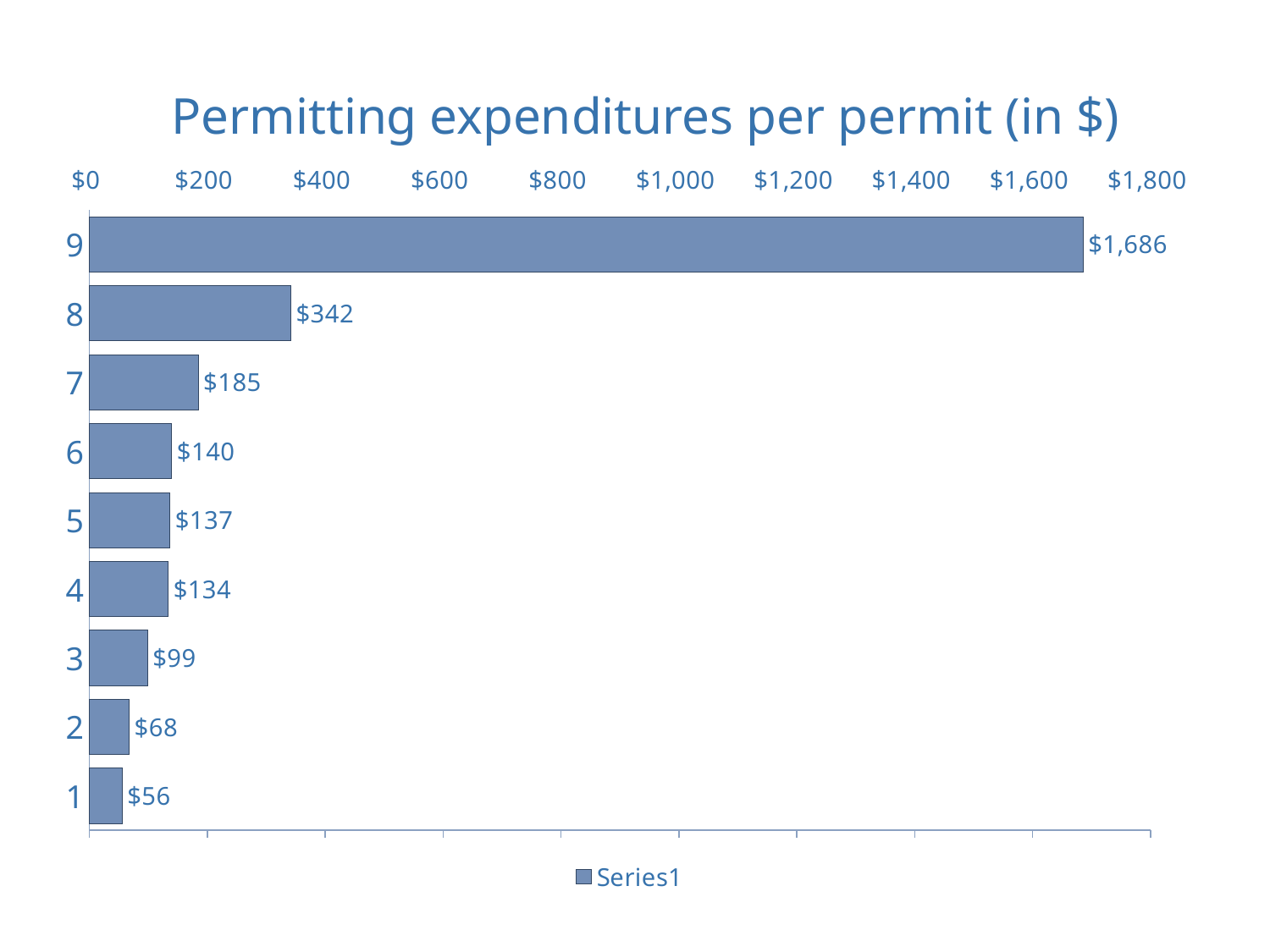
Is the value for category 8 greater or less than $200? greater What kind of chart is shown on the slide? bar chart What is the value shown for category 3? $99 What is the permitting expenditure per permit for category 9? $1,686 What is the difference between the values for category 7 and category 6? $45 What is the title of the chart? Permitting expenditures per permit (in $) How many categories are shown in the chart? 9 Which is larger, the value for category 2 or the value for category 3? 3 What is the difference between the values for category 9 and category 8? $1,344 Which category has the lowest permitting expenditure per permit? 1 What is the value shown for category 8? $342 Which category has the highest permitting expenditure per permit? 9